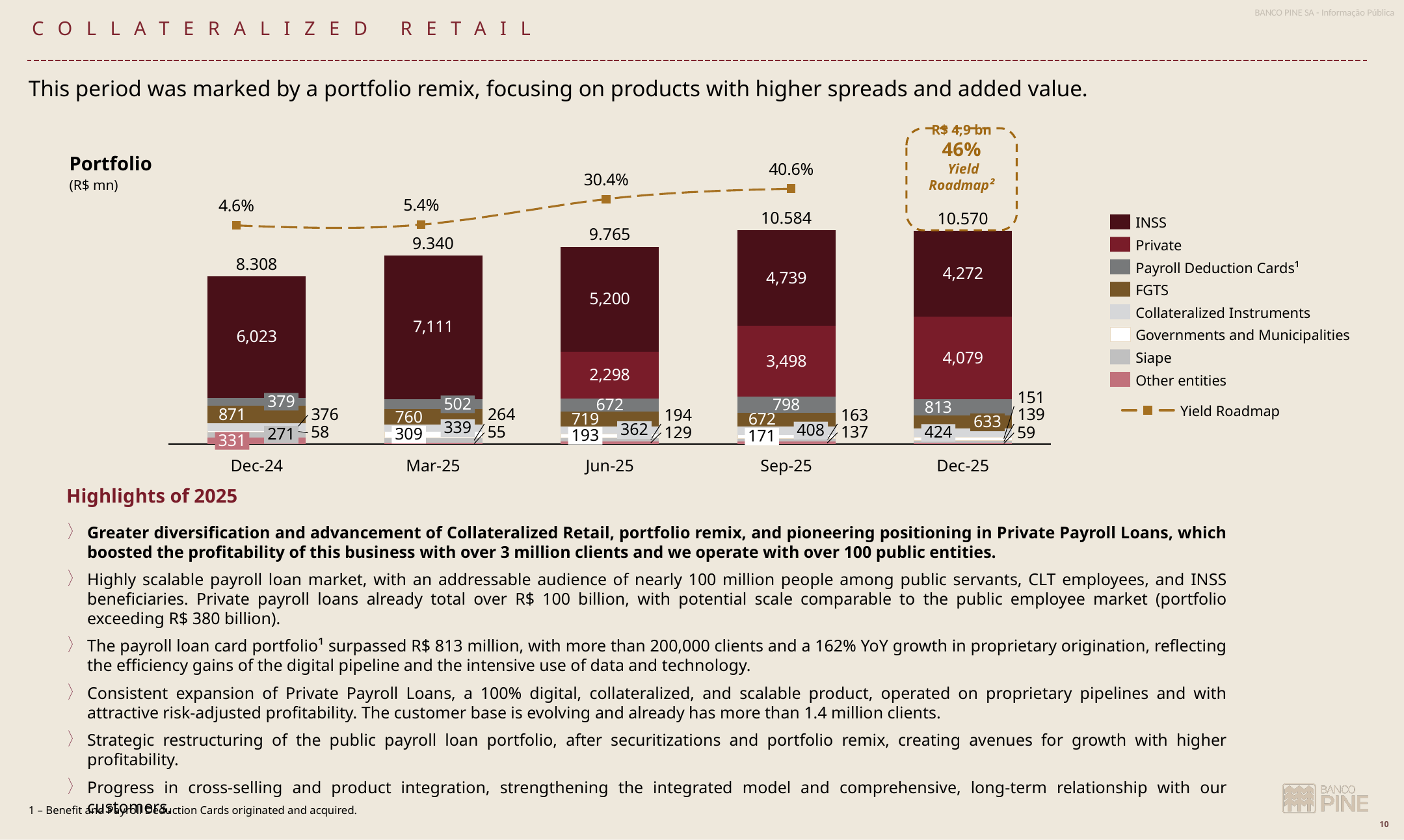
What is the Yield Roadmap value for Jun-25? 30.4% Which period has the lowest total portfolio value? Dec-24 What is the Private value for Dec-25? 4,079 Which period has the highest total portfolio value? Sep-25 What is the total portfolio value shown for Sep-25? 10.584 Which is larger, the Private value in Sep-25 or in Dec-25? Dec-25 What is the difference between the INSS value in Dec-24 and in Dec-25? 1,751 Does the Yield Roadmap line rise or fall from Dec-24 to Dec-25? Rise What kind of chart is the Portfolio chart? Stacked bar chart with a line What is the INSS value for Mar-25? 7,111 What is the total portfolio value shown for Dec-24? 8.308 How many periods are shown on the x axis of the Portfolio chart? 5